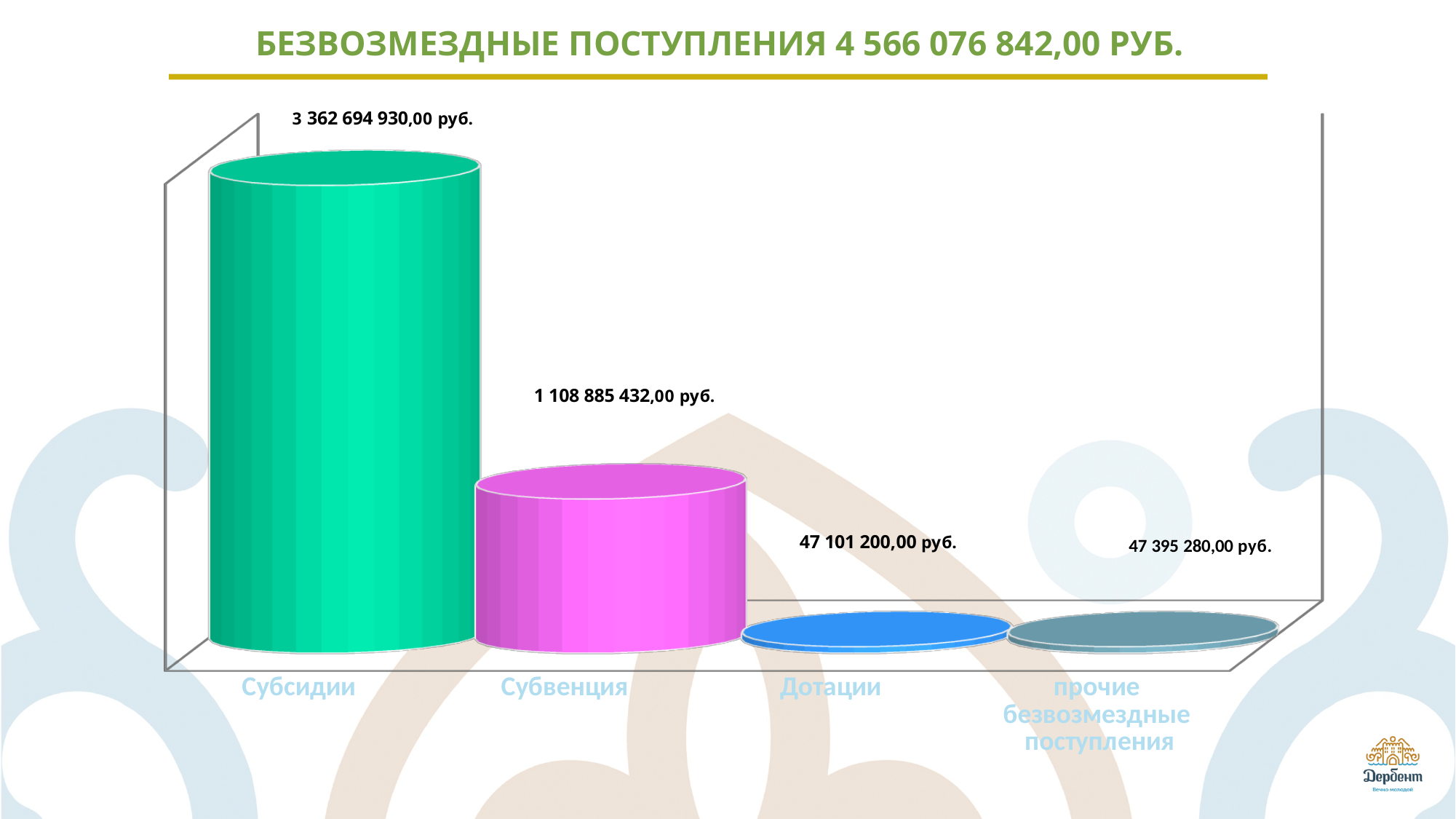
What is the value for Дотации? 47 101 200,00 руб. How many categories are shown in the chart? 4 What kind of chart is shown on the slide? Bar chart Which category has the lowest value? Дотации Which category has the highest value? Субсидии What is the difference between the values for прочие безвозмездные поступления and Дотации? 294 080,00 руб. What is the value for Субсидии? 3 362 694 930,00 руб. What is the value for прочие безвозмездные поступления? 47 395 280,00 руб. Which is larger, the value for Субвенция or the value for Дотации? Субвенция What is the value for Субвенция? 1 108 885 432,00 руб. What total amount is stated in the slide title? 4 566 076 842,00 РУБ. What is the difference between the values for Субсидии and Субвенция? 2 253 809 498,00 руб.